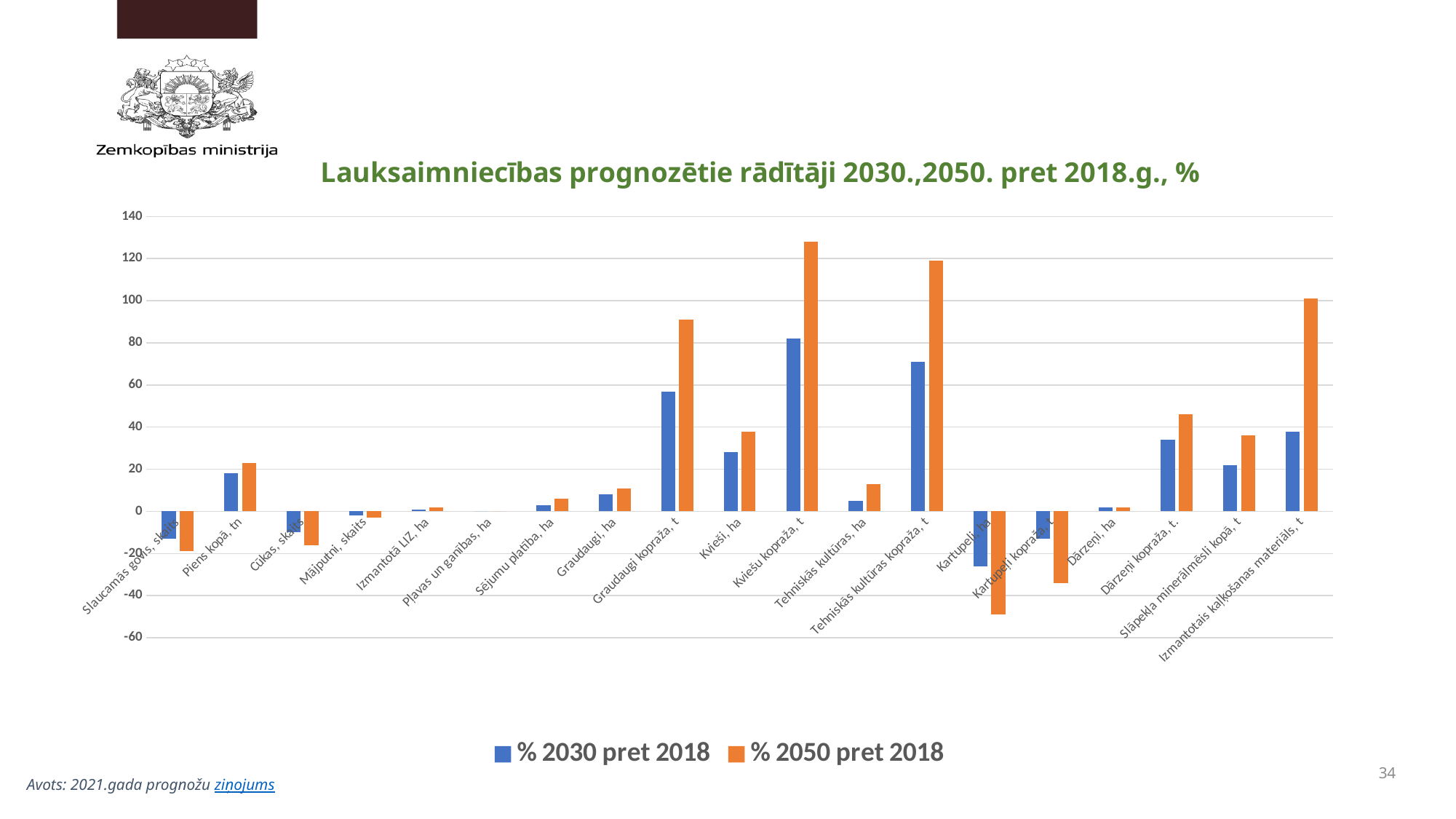
Which category has the highest value for the series '% 2030 pret 2018'? Kviešu kopraža, t Is the value for 'Kviešu kopraža, t' in the series '% 2050 pret 2018' greater or less than 120? greater Is the value for 'Kvieši, ha' in the series '% 2030 pret 2018' greater or less than 20? greater How many categories are shown on the x axis? 19 Is the value for 'Kartupeļi, ha' in the series '% 2050 pret 2018' greater or less than -40? less What kind of chart is shown on the slide? bar chart For the series '% 2050 pret 2018', which is larger: 'Dārzeņi kopraža, t' or 'Slāpekļa minerālmēsli kopā, t'? Dārzeņi kopraža, t Which category has the lowest value for the series '% 2050 pret 2018'? Kartupeļi, ha Which category has the highest value for the series '% 2050 pret 2018'? Kviešu kopraža, t How many series does the legend list? 2 What is the title of the chart? Lauksaimniecības prognozētie rādītāji 2030.,2050. pret 2018.g., %